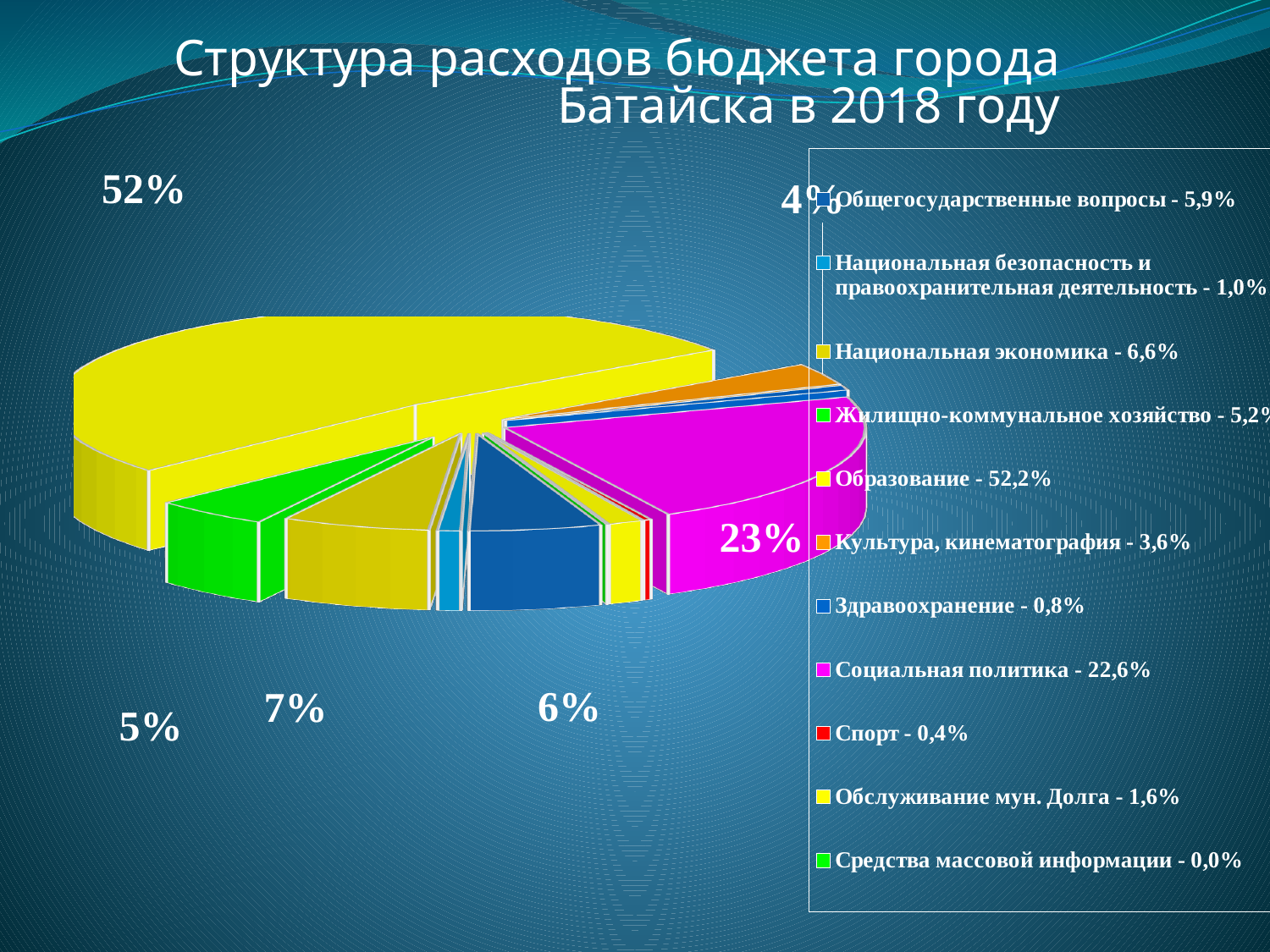
What share of expenditures goes to Национальная экономика according to the legend? 6,6% What data label is shown on the largest slice of the pie? 52% How many categories does the legend list? 11 What is the title of the chart on the slide? Структура расходов бюджета города Батайска в 2018 году What share of expenditures goes to Образование according to the legend? 52,2% By how many percentage points does the share for Образование exceed the share for Социальная политика? 29,6 Which category has the smallest share of the budget expenditures? Средства массовой информации Which category has the largest share of the budget expenditures? Образование Which is larger: the share for Общегосударственные вопросы or the share for Жилищно-коммунальное хозяйство? Общегосударственные вопросы What kind of chart is shown on the slide? pie chart What share of expenditures goes to Спорт according to the legend? 0,4% What share of expenditures goes to Социальная политика according to the legend? 22,6%